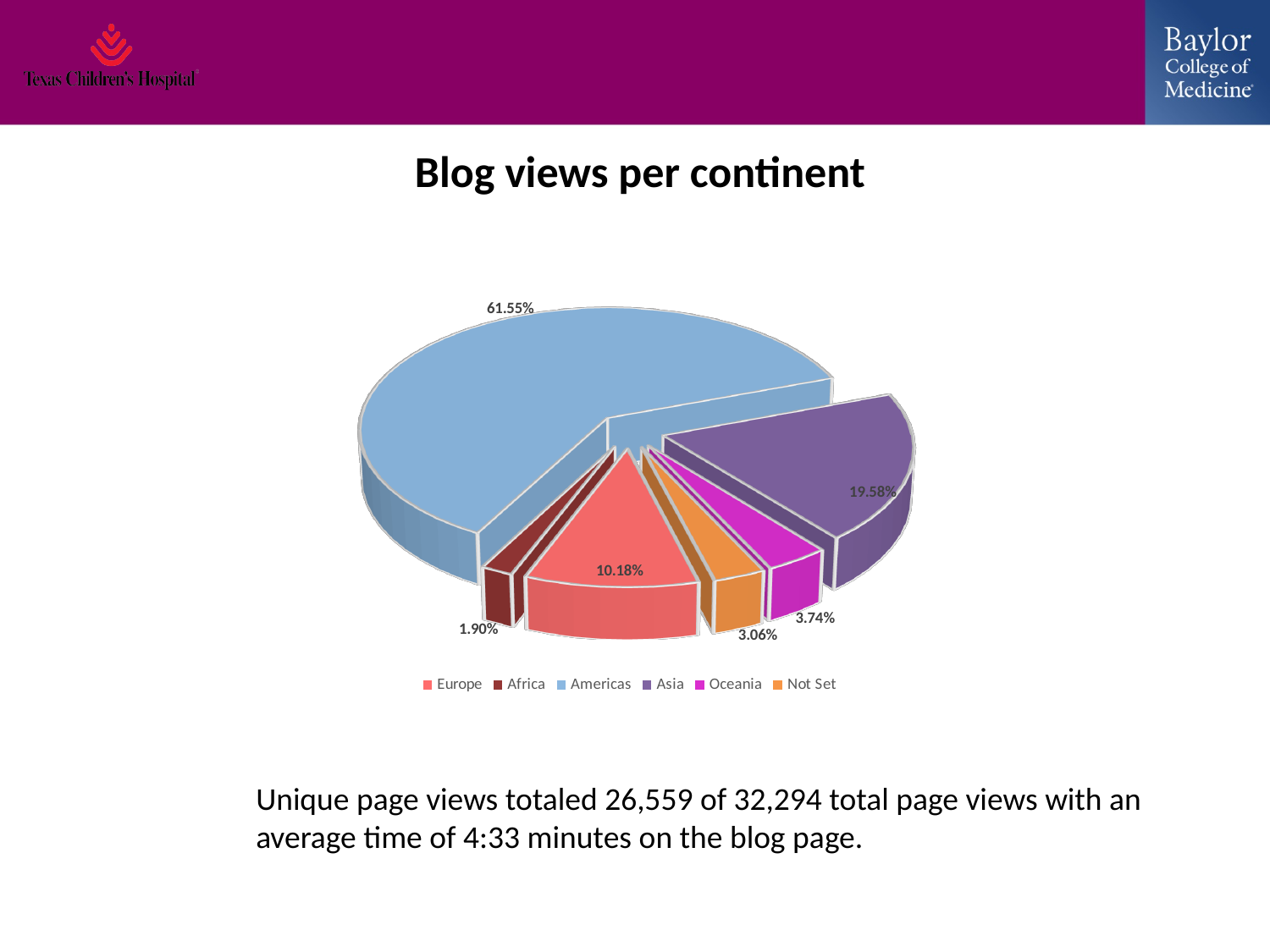
Which category has the smallest share of blog views? Africa What share of blog views does Asia represent? 19.58% What is the title of the chart? Blog views per continent Which continent has the largest share of blog views? Americas What is the difference in percentage points between the Americas and Asia shares? 41.97 What share of blog views does the Americas slice represent? 61.55% What kind of chart is shown on the slide? Pie chart How many categories does the legend list? 6 What percentage of blog views is attributed to Africa? 1.90% What percentage of blog views is labelled Not Set? 3.06% Which has a larger share of blog views, Oceania or Not Set? Oceania What percentage of blog views is attributed to Europe? 10.18%